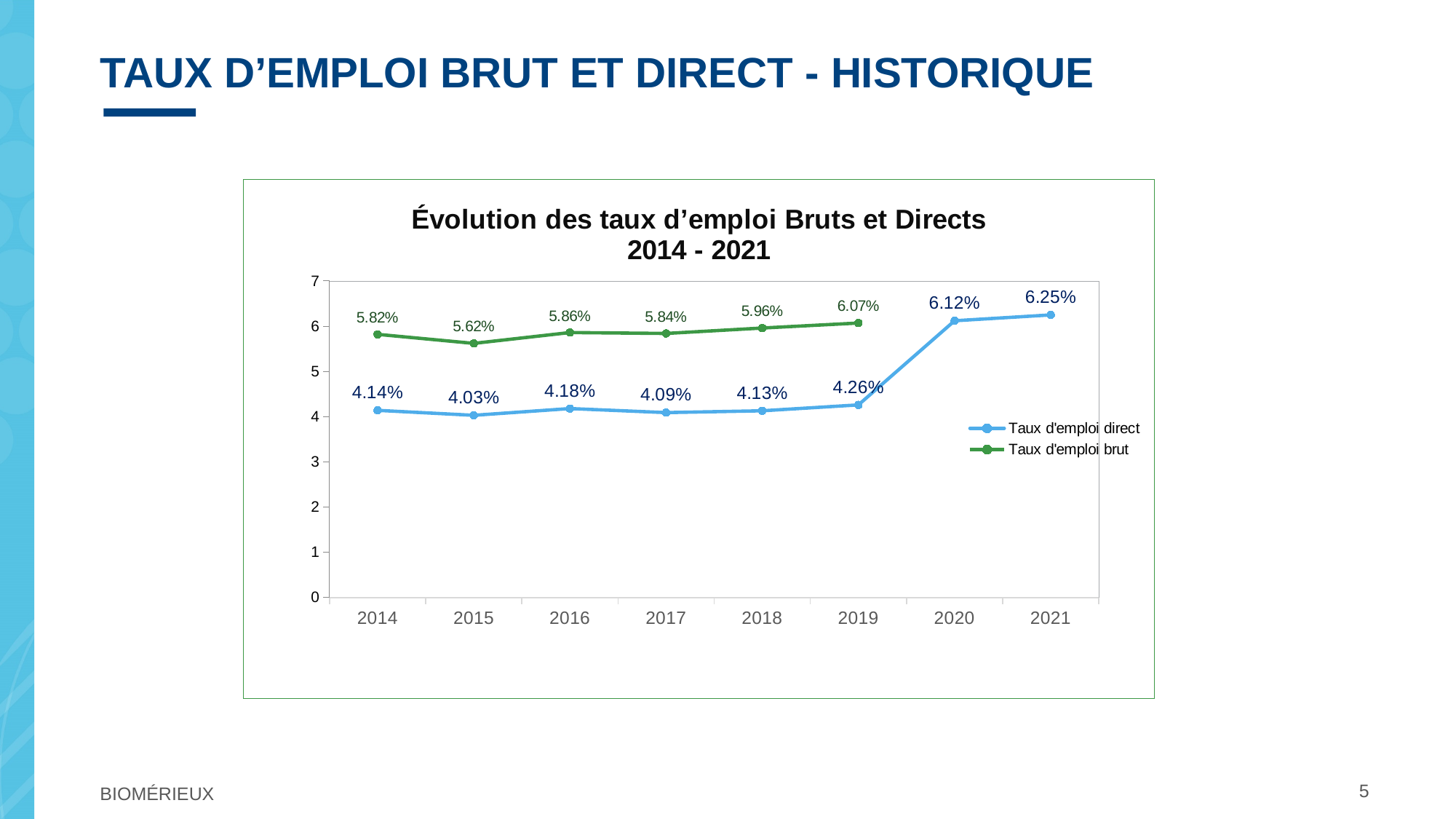
How many years are shown on the x axis? 8 Does Taux d'emploi direct rise or fall between 2019 and 2020? Rise What is the value of Taux d'emploi brut in 2015? 5.62% In which year is Taux d'emploi direct the lowest? 2015 What is the value of Taux d'emploi direct in 2021? 6.25% What is the title of the chart? Évolution des taux d'emploi Bruts et Directs 2014 - 2021 What is the value of Taux d'emploi direct in 2017? 4.09% How many series does the legend list? 2 In which year is Taux d'emploi brut the highest? 2019 Which is larger in 2019: Taux d'emploi brut or Taux d'emploi direct? Taux d'emploi brut What type of chart is shown on the slide? Line chart What is the difference between Taux d'emploi brut and Taux d'emploi direct in 2014? 1.68%